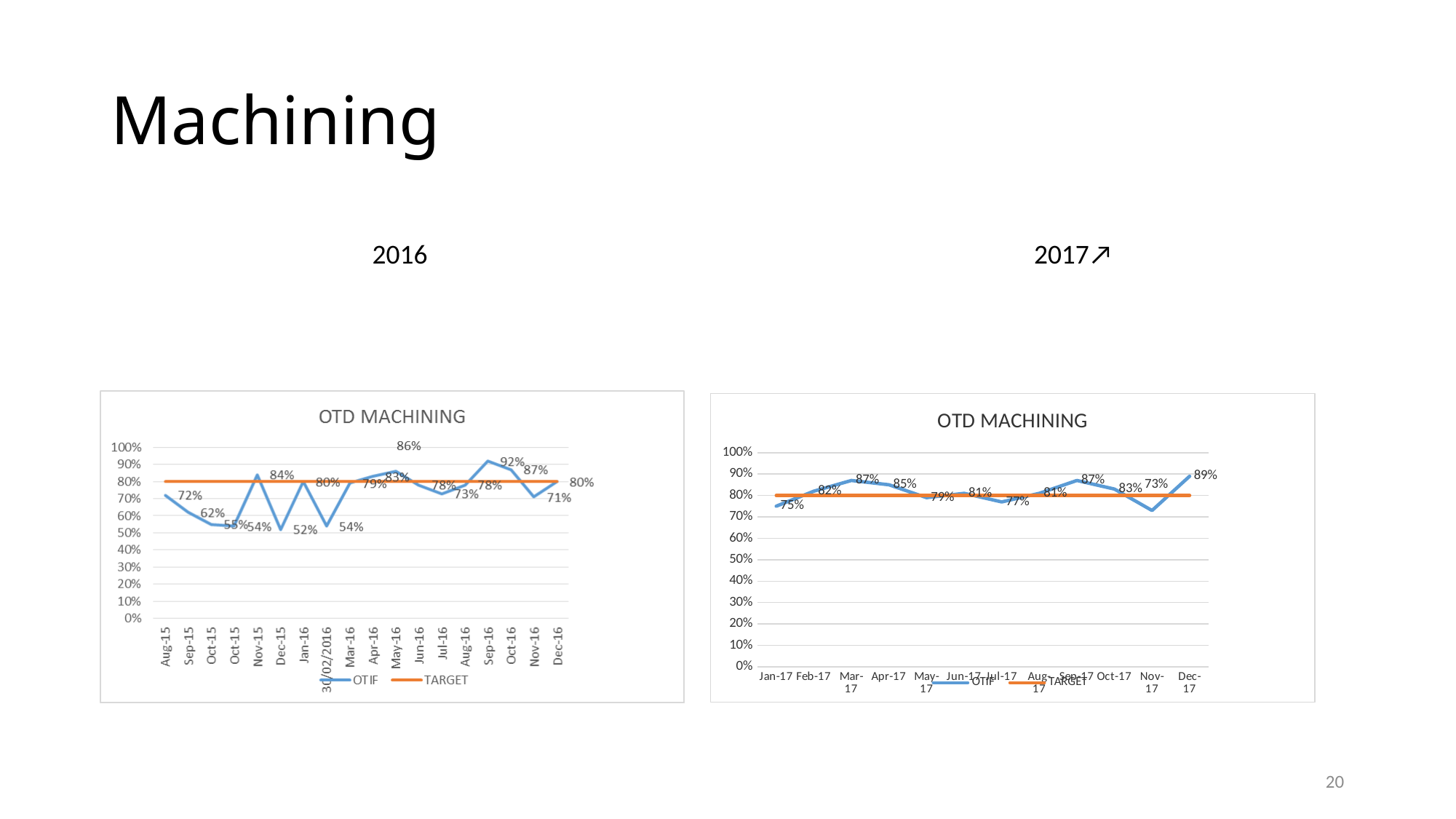
In the right-hand chart (2017), what is the difference between the OTIF values for Dec-17 and Nov-17? 16% In the left-hand chart (2016), what is the OTIF value for Sep-16? 92% In the right-hand chart (2017), what is the OTIF value for Jan-17? 75% In the left-hand chart (2016), is the OTIF value for Dec-15 greater or less than 60%? less In the left-hand chart (2016), what is the OTIF value for Aug-15? 72% In the right-hand chart (2017), how many months are plotted on the x axis? 12 In the left-hand chart (2016), which month has the highest OTIF value? Sep-16 What kind of chart is the right-hand chart (2017)? line chart In the right-hand chart (2017), which month has the lowest OTIF value? Nov-17 In the right-hand chart (2017), what is the OTIF value for Dec-17? 89% In the right-hand chart (2017), how many series does the legend list? 2 In the right-hand chart (2017), which month has the highest OTIF value? Dec-17